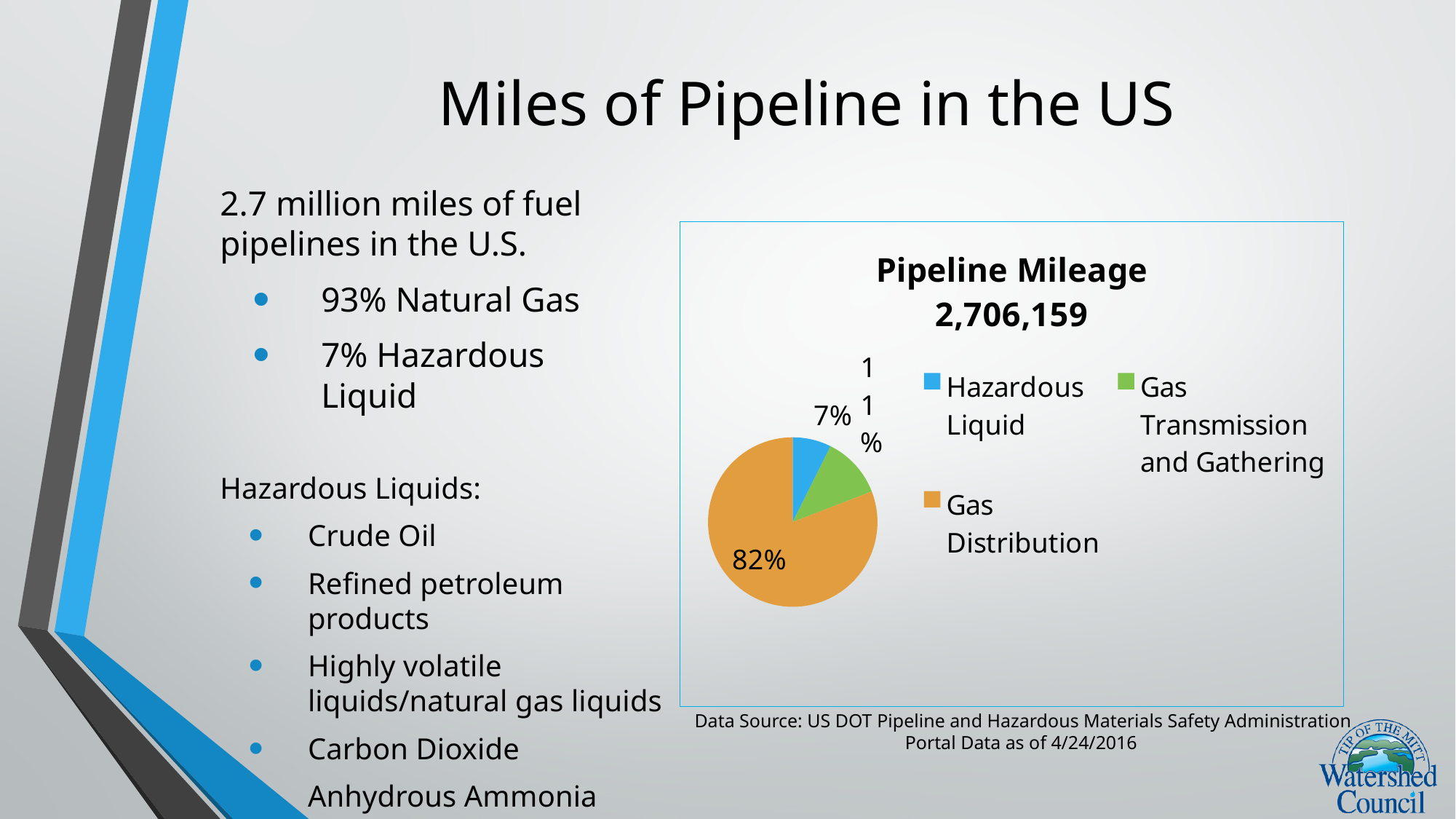
What share of the pie does Hazardous Liquid represent? 7% What colour is the Gas Distribution slice in the pie chart? orange What is the title of the chart? Pipeline Mileage 2,706,159 How many slices does the pie chart have? 3 Which category has the largest slice of the pie? Gas Distribution What kind of chart is shown on the slide? pie chart Which category has the smallest slice of the pie? Hazardous Liquid How many entries does the chart legend list? 3 What share of the pie does Gas Transmission and Gathering represent? 11% What share of the pie does Gas Distribution represent? 82% Which is larger, the share for Gas Transmission and Gathering or the share for Hazardous Liquid? Gas Transmission and Gathering What is the difference in percentage points between the Gas Distribution share and the Hazardous Liquid share? 75